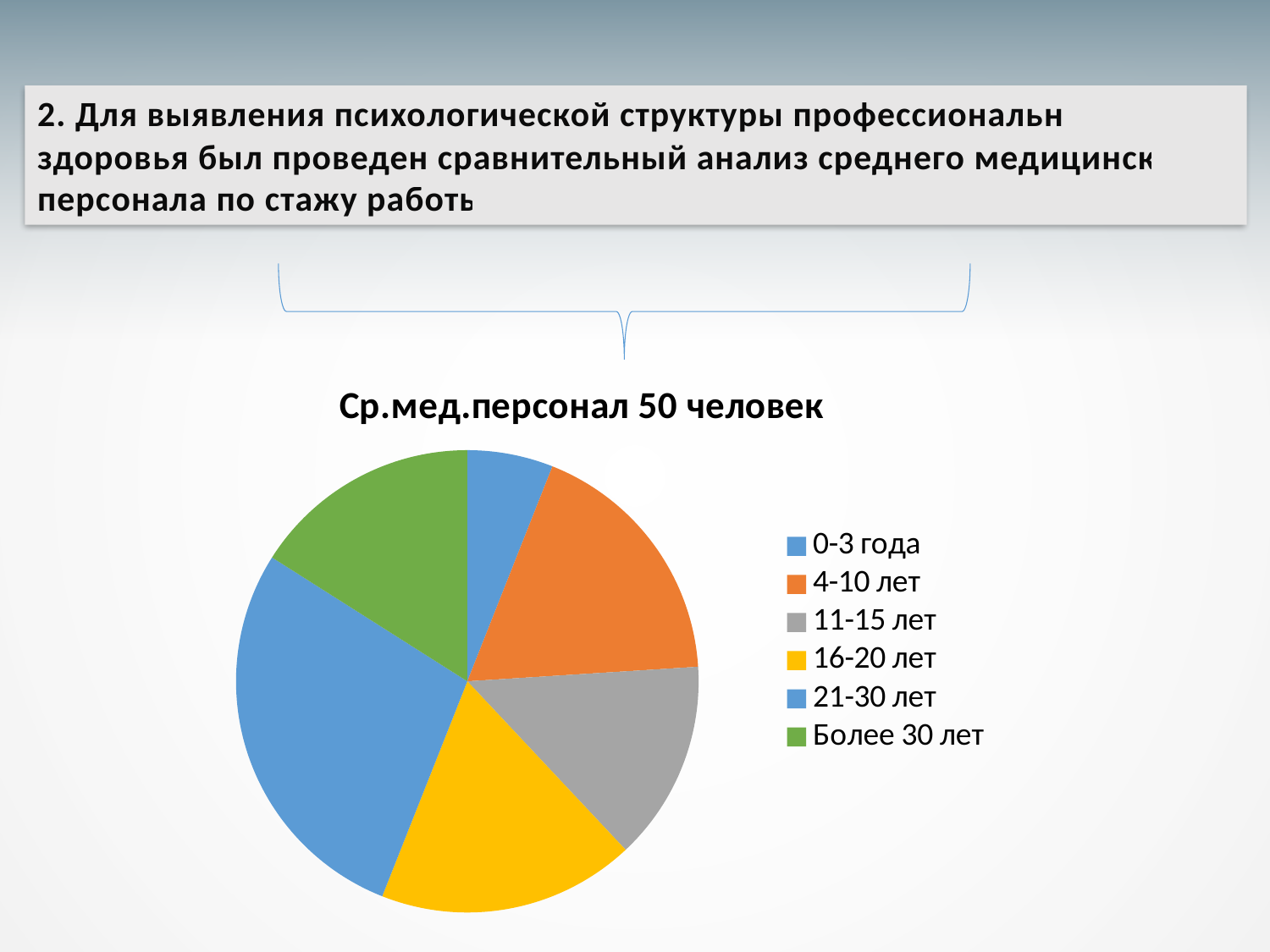
Which category has the largest slice of the pie chart? 21-30 лет What kind of chart is shown on the slide? pie chart What is the title of the pie chart? Ср.мед.персонал 50 человек Which slice is larger: 0-3 года or 11-15 лет? 11-15 лет Which slice is larger: 21-30 лет or 16-20 лет? 21-30 лет Which slice is larger: 0-3 года or Более 30 лет? Более 30 лет How many categories (slices) does the pie chart have? 6 Which category is shown in green in the pie chart? Более 30 лет Which category has the smallest slice of the pie chart? 0-3 года